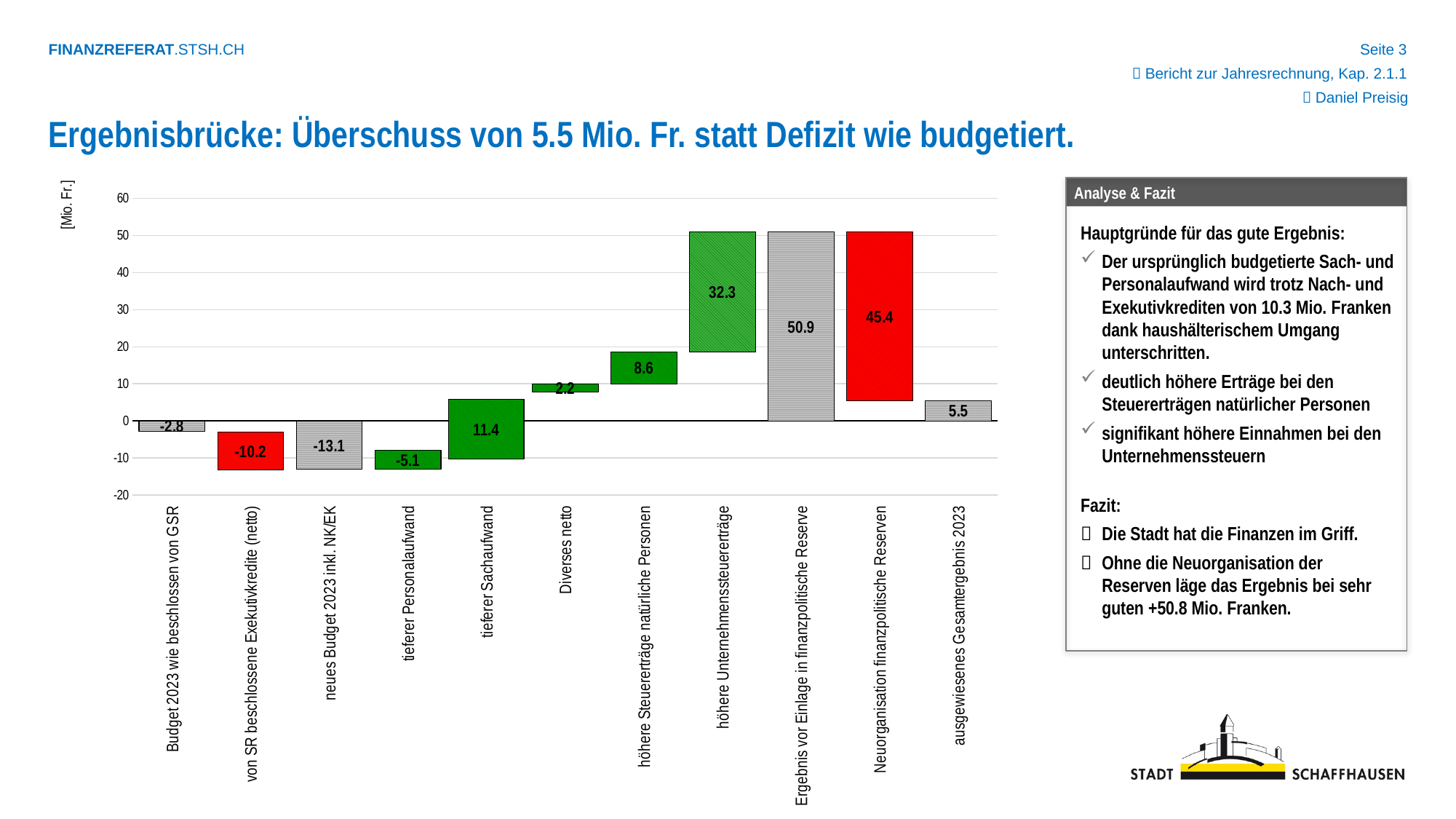
How many categories are shown on the x axis of the chart? 11 What is the value shown for 'neues Budget 2023 inkl. NK/EK'? -13.1 What is the value shown for 'höhere Unternehmenssteuererträge'? 32.3 What is the value shown for 'ausgewiesenes Gesamtergebnis 2023'? 5.5 Which category has the lowest value in the chart? neues Budget 2023 inkl. NK/EK Is the value for 'Neuorganisation finanzpolitische Reserven' greater or less than 40? greater What is the difference between the values for 'höhere Unternehmenssteuererträge' and 'höhere Steuererträge natürliche Personen'? 23.7 What unit is given on the y axis of the chart? [Mio. Fr.] What kind of chart is shown on the slide? bar chart What is the value shown for 'tieferer Sachaufwand'? 11.4 Which is larger: the value for 'tieferer Sachaufwand' or for 'höhere Steuererträge natürliche Personen'? tieferer Sachaufwand Which category has the highest value in the chart? Ergebnis vor Einlage in finanzpolitische Reserve